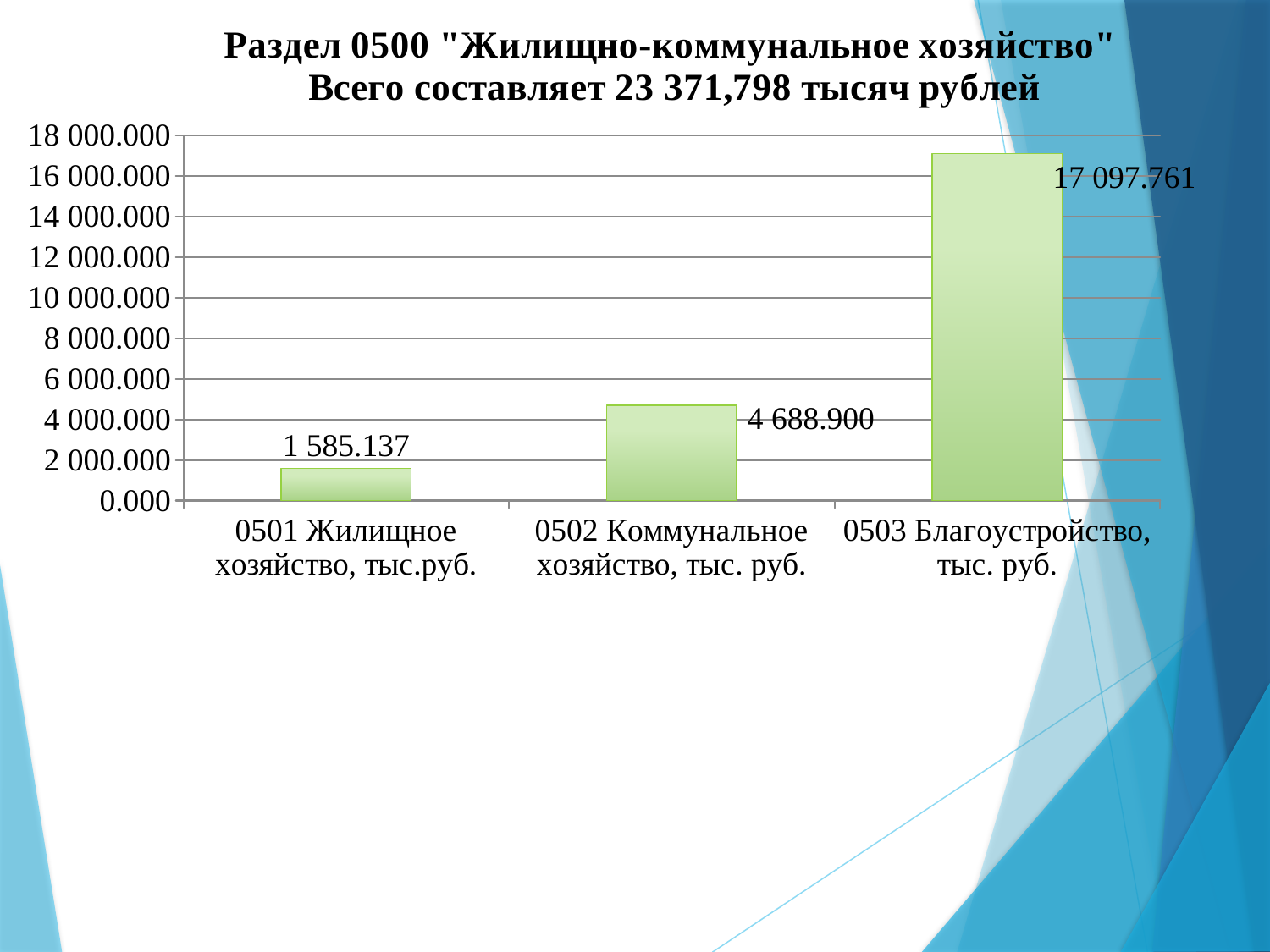
What is the value for 0503 Благоустройство? 17 097.761 What is the value for 0501 Жилищное хозяйство? 1 585.137 What is the value for 0502 Коммунальное хозяйство? 4 688.900 According to the slide title, what is the total for Раздел 0500? 23 371,798 тысяч рублей What is the difference between the values for 0502 Коммунальное хозяйство and 0501 Жилищное хозяйство? 3 103.763 What is the difference between the values for 0503 Благоустройство and 0502 Коммунальное хозяйство? 12 408.861 Which is larger, the value for 0502 Коммунальное хозяйство or the value for 0501 Жилищное хозяйство? 0502 Коммунальное хозяйство Which category has the highest value? 0503 Благоустройство, тыс. руб. Which category has the lowest value? 0501 Жилищное хозяйство, тыс.руб. Is the value for 0503 Благоустройство greater or less than 16 000.000? greater How many categories are shown in the chart? 3 What kind of chart is shown on the slide? bar chart